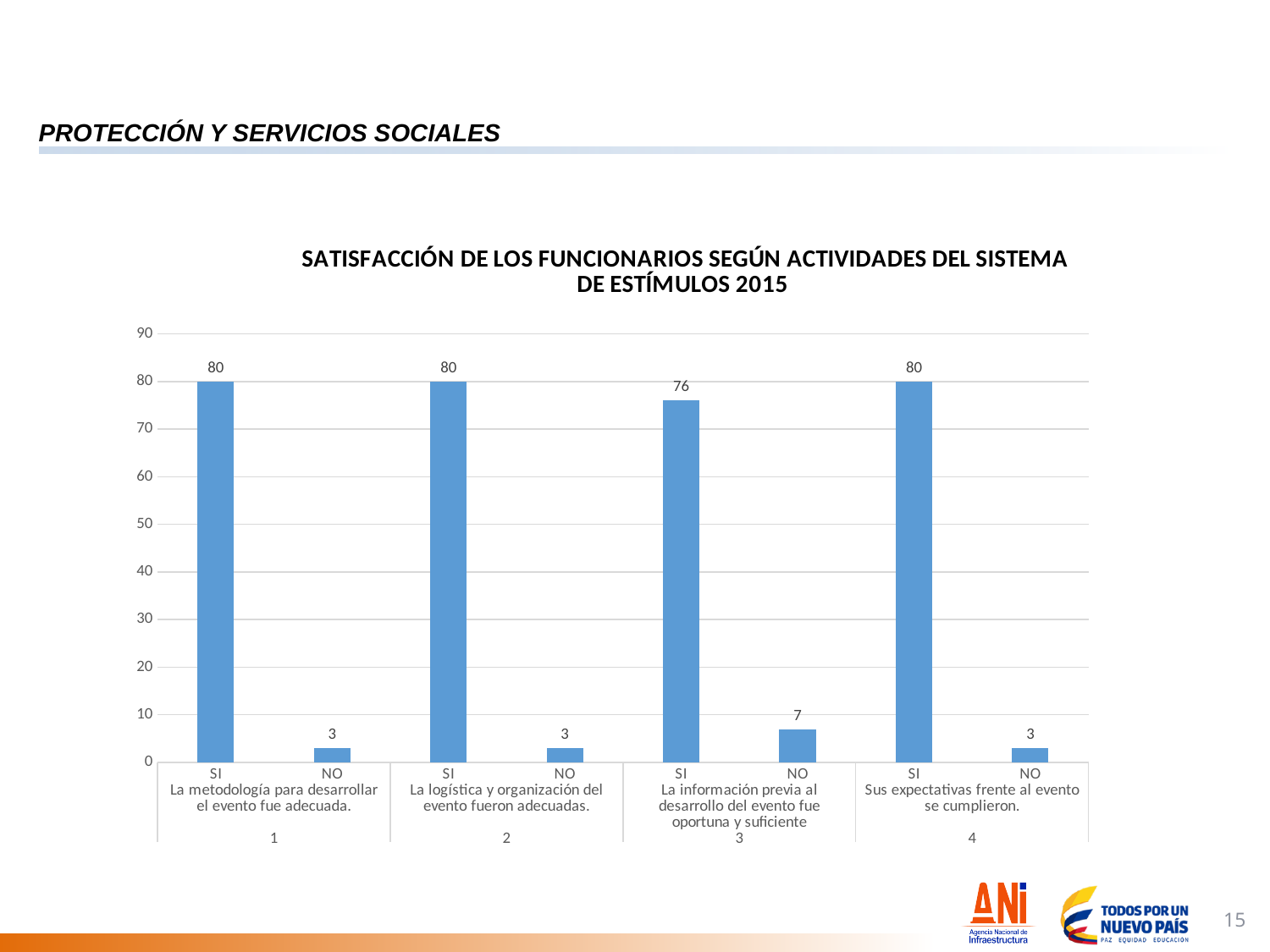
Which question has the lowest SI value? La información previa al desarrollo del evento fue oportuna y suficiente What is the value for NO under 'Sus expectativas frente al evento se cumplieron.'? 3 What is the difference between the SI and NO values for 'La logística y organización del evento fueron adecuadas.'? 77 What is the value for SI under 'La metodología para desarrollar el evento fue adecuada.'? 80 How many bars are plotted in the chart? 8 What is the value for SI under 'La información previa al desarrollo del evento fue oportuna y suficiente'? 76 What kind of chart is shown on the slide? bar chart What is the difference between the SI and NO values for 'La información previa al desarrollo del evento fue oportuna y suficiente'? 69 What is the title of the chart? SATISFACCIÓN DE LOS FUNCIONARIOS SEGÚN ACTIVIDADES DEL SISTEMA DE ESTÍMULOS 2015 What is the value for NO under 'La información previa al desarrollo del evento fue oportuna y suficiente'? 7 Which question has the highest NO value? La información previa al desarrollo del evento fue oportuna y suficiente Is the NO value for 'La información previa al desarrollo del evento fue oportuna y suficiente' larger or smaller than the NO value for 'Sus expectativas frente al evento se cumplieron.'? larger